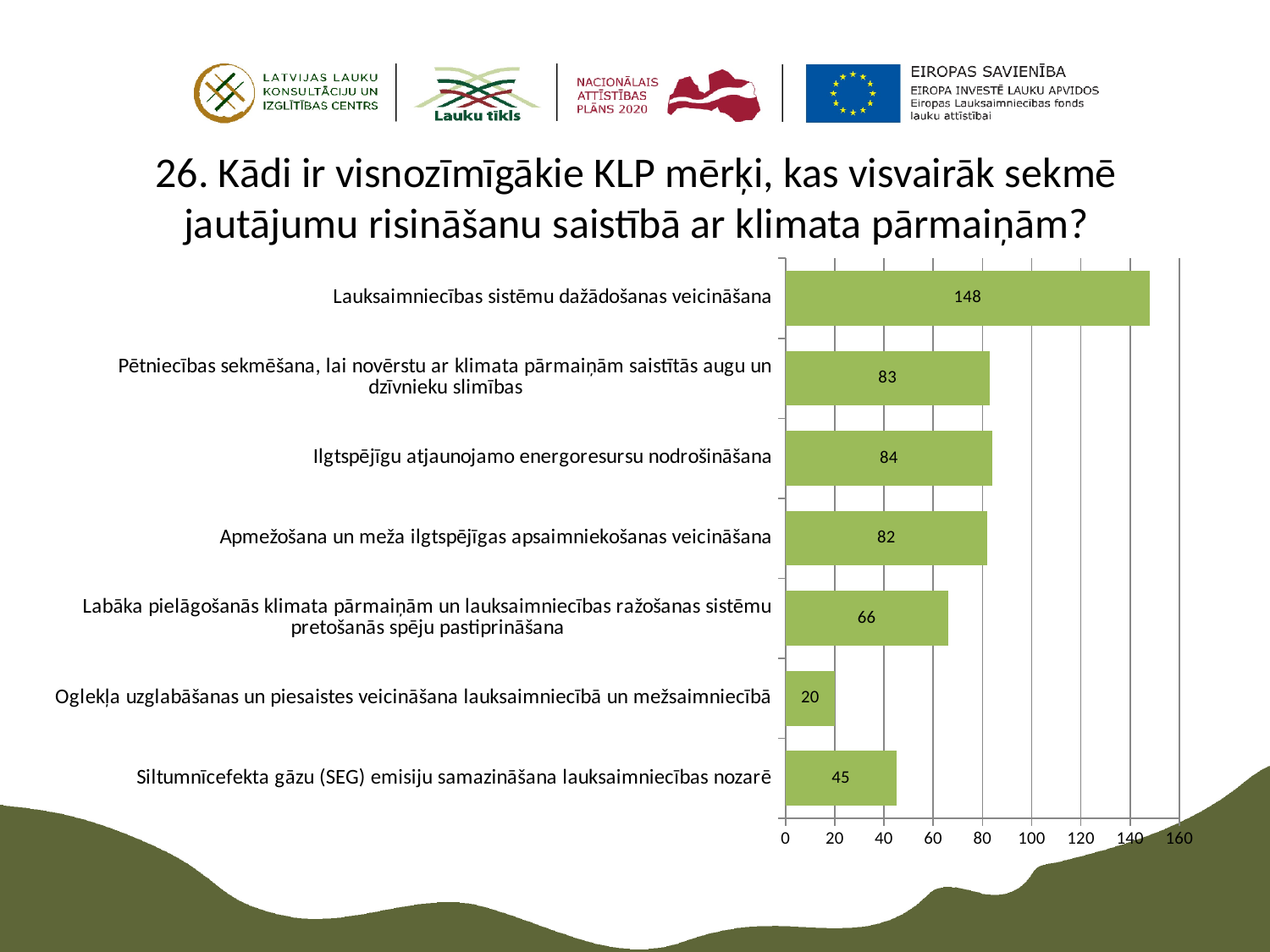
What is the value for "Siltumnīcefekta gāzu (SEG) emisiju samazināšana lauksaimniecības nozarē"? 45 What is the value for "Ilgtspējīgu atjaunojamo energoresursu nodrošināšana"? 84 What is the maximum value shown on the horizontal axis? 160 What kind of chart is shown on the slide? bar chart Which is larger: the value for "Apmežošana un meža ilgtspējīgas apsaimniekošanas veicināšana" or the value for "Labāka pielāgošanās klimata pārmaiņām un lauksaimniecības ražošanas sistēmu pretošanās spēju pastiprināšana"? Apmežošana un meža ilgtspējīgas apsaimniekošanas veicināšana What is the difference between the values for "Labāka pielāgošanās klimata pārmaiņām un lauksaimniecības ražošanas sistēmu pretošanās spēju pastiprināšana" and "Siltumnīcefekta gāzu (SEG) emisiju samazināšana lauksaimniecības nozarē"? 21 Which category has the lowest value? Oglekļa uzglabāšanas un piesaistes veicināšana lauksaimniecībā un mežsaimniecībā How many categories are shown in the chart? 7 Is the value for "Oglekļa uzglabāšanas un piesaistes veicināšana lauksaimniecībā un mežsaimniecībā" greater or less than 40? less What is the difference between the values for "Lauksaimniecības sistēmu dažādošanas veicināšana" and "Pētniecības sekmēšana, lai novērstu ar klimata pārmaiņām saistītās augu un dzīvnieku slimības"? 65 What is the value for "Lauksaimniecības sistēmu dažādošanas veicināšana"? 148 Which category has the highest value? Lauksaimniecības sistēmu dažādošanas veicināšana